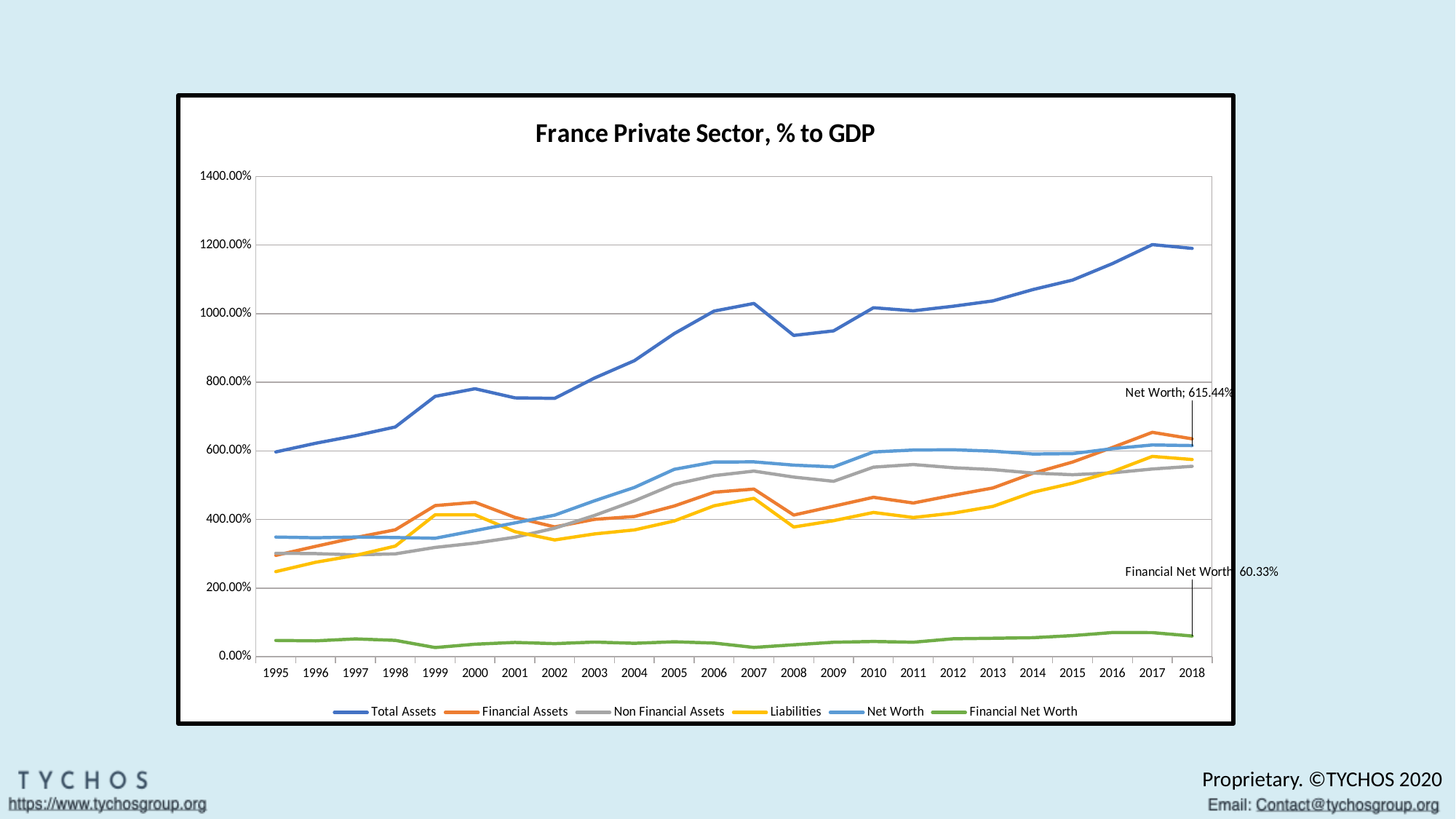
Which series has the lowest values across the whole period? Financial Net Worth Is the value for Total Assets in 2017 greater or less than 1000.00%? greater What is the Financial Net Worth value labelled for 2018? 60.33% How many years are shown on the x axis? 24 Which series has the highest value in 2018? Total Assets How many series does the legend list? 6 Is the value for Liabilities in 1995 greater or less than 400.00%? less What is the title of the chart? France Private Sector, % to GDP Does the Total Assets series generally rise or fall from 1995 to 2018? rise What kind of chart is shown on the slide? line chart What is the difference between the labelled 2018 Net Worth and Financial Net Worth values? 555.11% What is the Net Worth value labelled for 2018? 615.44%